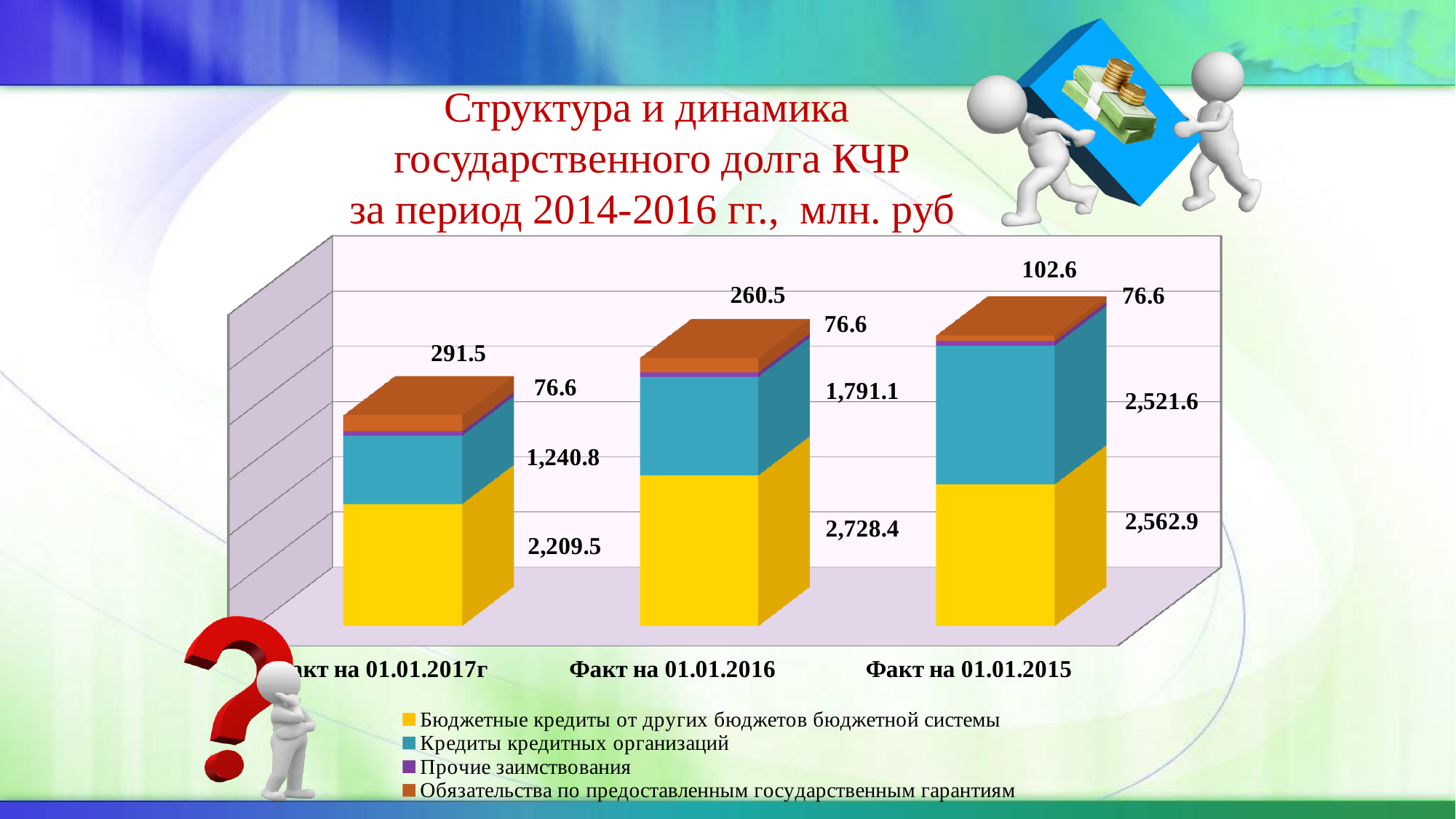
Which is larger for 'Факт на 01.01.2015': 'Бюджетные кредиты от других бюджетов бюджетной системы' or 'Кредиты кредитных организаций'? Бюджетные кредиты от других бюджетов бюджетной системы For which date is 'Кредиты кредитных организаций' the lowest? Факт на 01.01.2017г What type of chart is shown on the slide? Stacked bar chart What is the total of the stacked bar for 'Факт на 01.01.2017г'? 3,818.4 For which date is 'Обязательства по предоставленным государственным гарантиям' the highest? Факт на 01.01.2017г What is the difference between 'Бюджетные кредиты от других бюджетов бюджетной системы' for 'Факт на 01.01.2016' and for 'Факт на 01.01.2017г'? 518.9 What is the value of 'Бюджетные кредиты от других бюджетов бюджетной системы' for 'Факт на 01.01.2016'? 2,728.4 What is the value of 'Кредиты кредитных организаций' for 'Факт на 01.01.2015'? 2,521.6 How many series does the legend list? 4 How many categories (dates) are shown on the x axis? 3 What is the value of 'Прочие заимствования' for 'Факт на 01.01.2016'? 76.6 What is the value of 'Обязательства по предоставленным государственным гарантиям' for 'Факт на 01.01.2017г'? 291.5